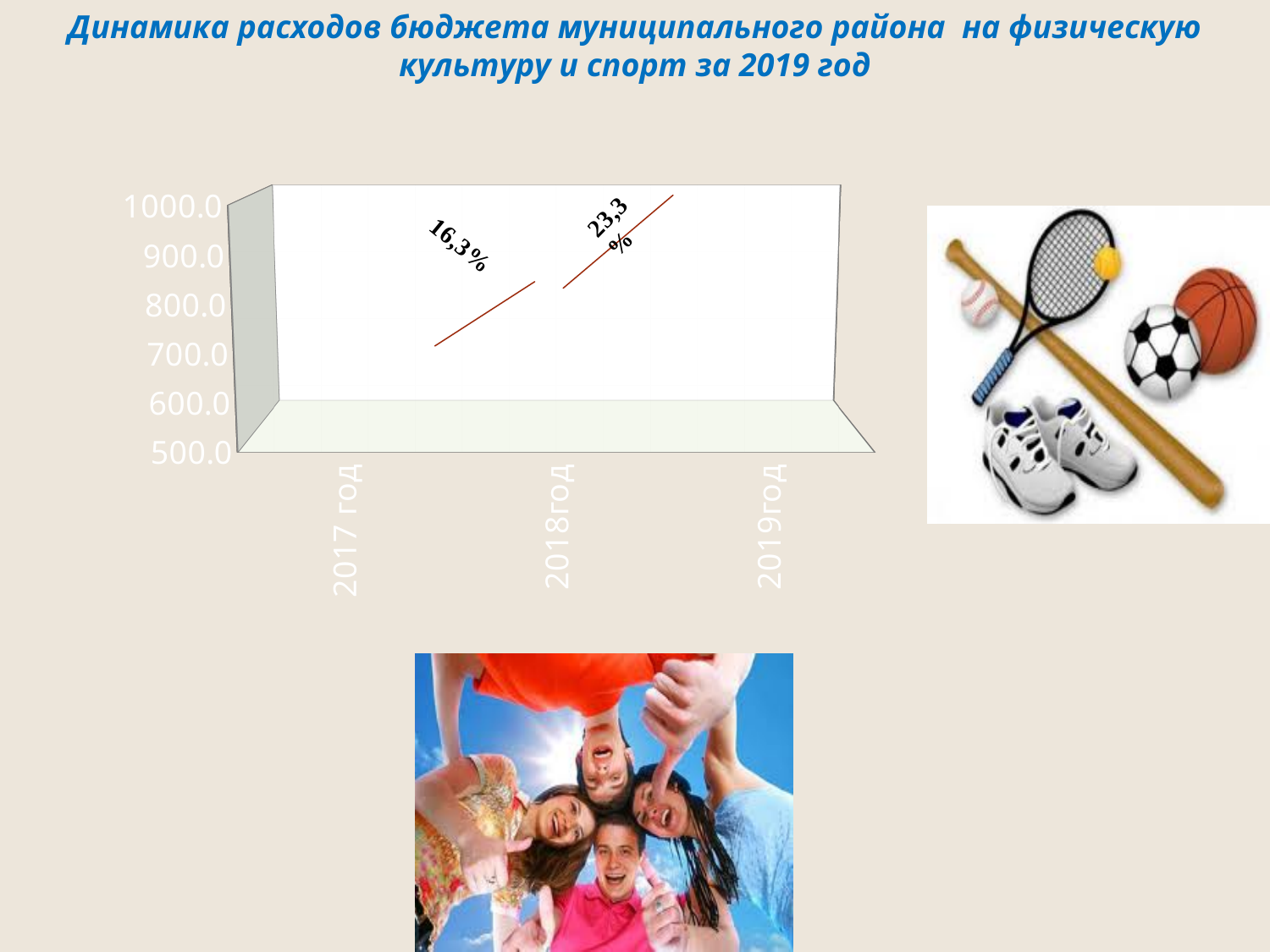
What percentage label is printed on the line segment between 2017 год and 2018год? 16,3% How many categories are shown on the x axis of the chart? 3 Do the values rise or fall from 2017 год to 2019год? rise Which is larger, the value for 2017 год or the value for 2019год? 2019год Which year has the highest value on the chart? 2019год What is the lowest value shown on the vertical axis of the chart? 500.0 What percentage label is printed on the line segment between 2018год and 2019год? 23,3% Which year has the lowest value on the chart? 2017 год What is the highest value shown on the vertical axis of the chart? 1000.0